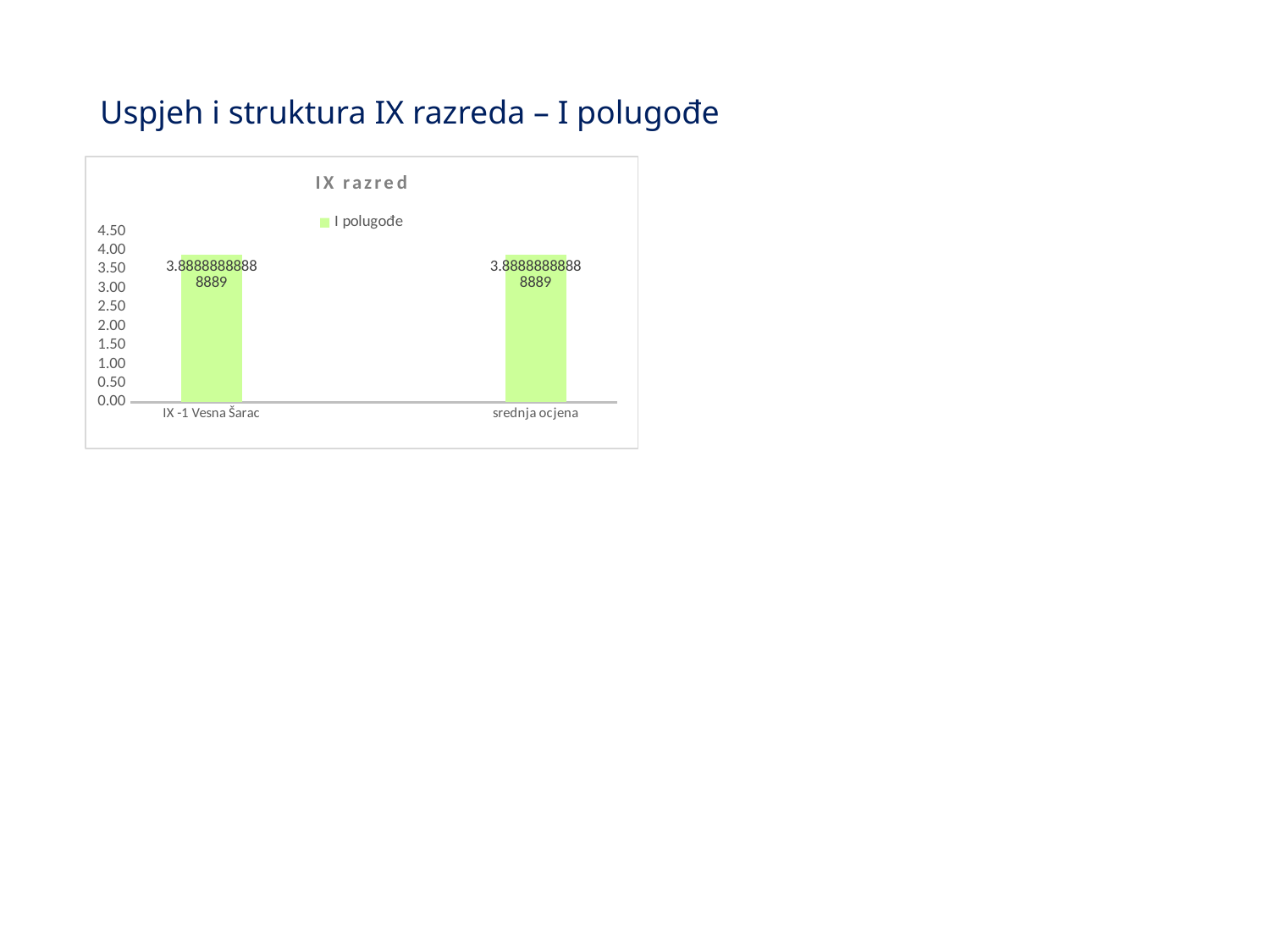
What type of chart is shown on the slide? bar chart What is the name of the series shown in the legend? I polugođe How many series does the legend list? 1 Is the value for IX -1 Vesna Šarac greater or less than 3.50? greater Is the value for IX -1 Vesna Šarac greater or less than 2.00? greater What is the difference between the values for IX -1 Vesna Šarac and srednja ocjena? 0 What is the value for IX -1 Vesna Šarac? 3.88888888888889 Is the value for srednja ocjena greater or less than 4.00? less How many categories are shown on the x axis? 2 What is the title of the chart? IX razred What is the value for srednja ocjena? 3.88888888888889